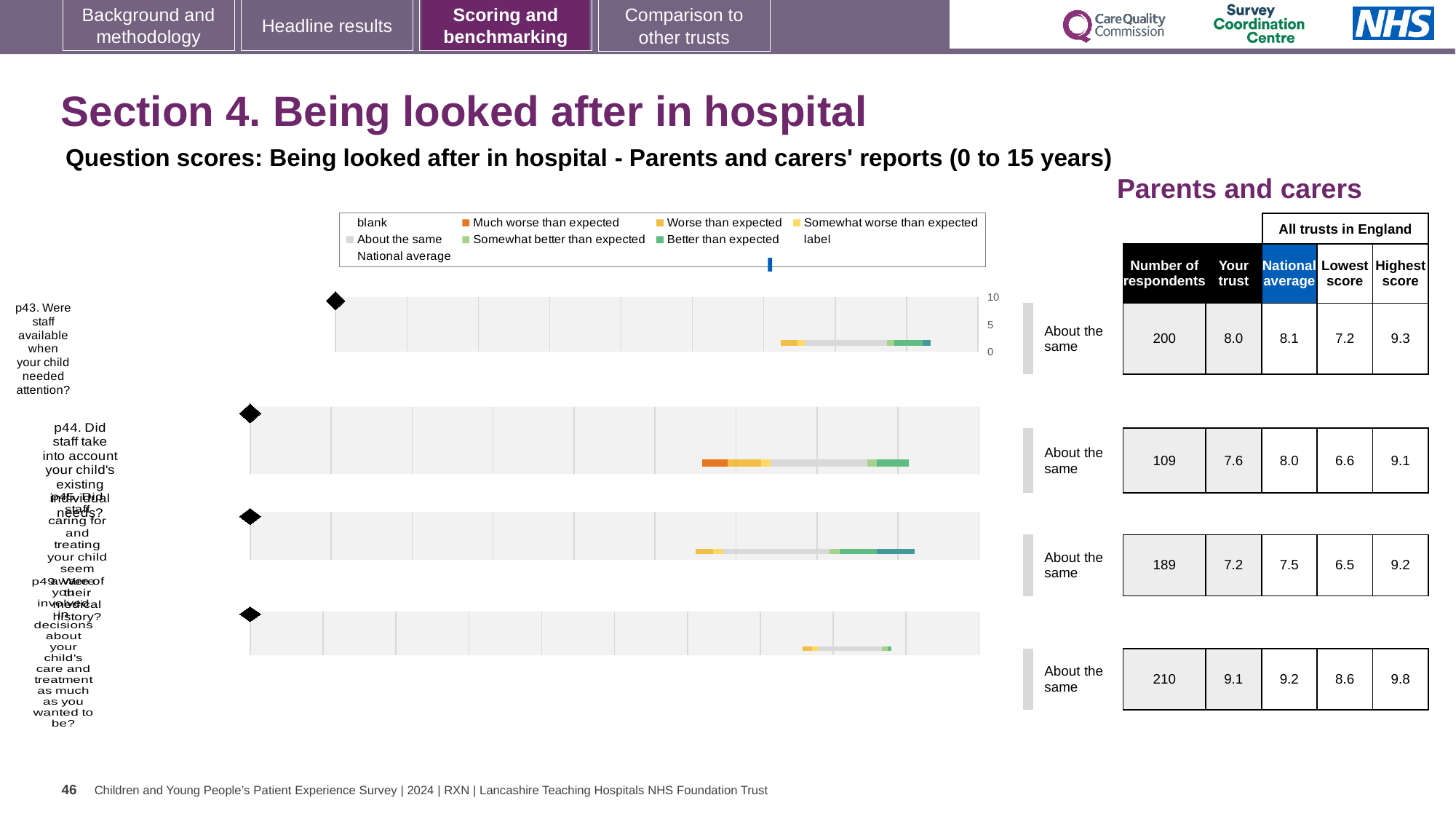
What kind of chart is used to show each question's score? Bar chart What is the 'Your trust' score for p43 (Were staff available when your child needed attention?)? 8.0 How many question charts are shown on the slide? 4 What is the national average score for p43 (Were staff available when your child needed attention?)? 8.1 Which row of the table has the highest 'Your trust' score? The fourth row (210 respondents), 9.1 What benchmark category label is shown beside each of the four charts? About the same What is the highest score among all trusts in England for p43 (Were staff available when your child needed attention?)? 9.3 For the second row (109 respondents), what is the difference between the national average and the 'Your trust' score? 0.4 What is the lowest 'Your trust' score shown in the table? 7.2 In the table next to the charts, how many respondents are listed for p43 (Were staff available when your child needed attention?)? 200 For the fourth row (210 respondents), what is the difference between the highest score and the lowest score? 1.2 For p43, which is larger: the 'Your trust' score or the national average? National average